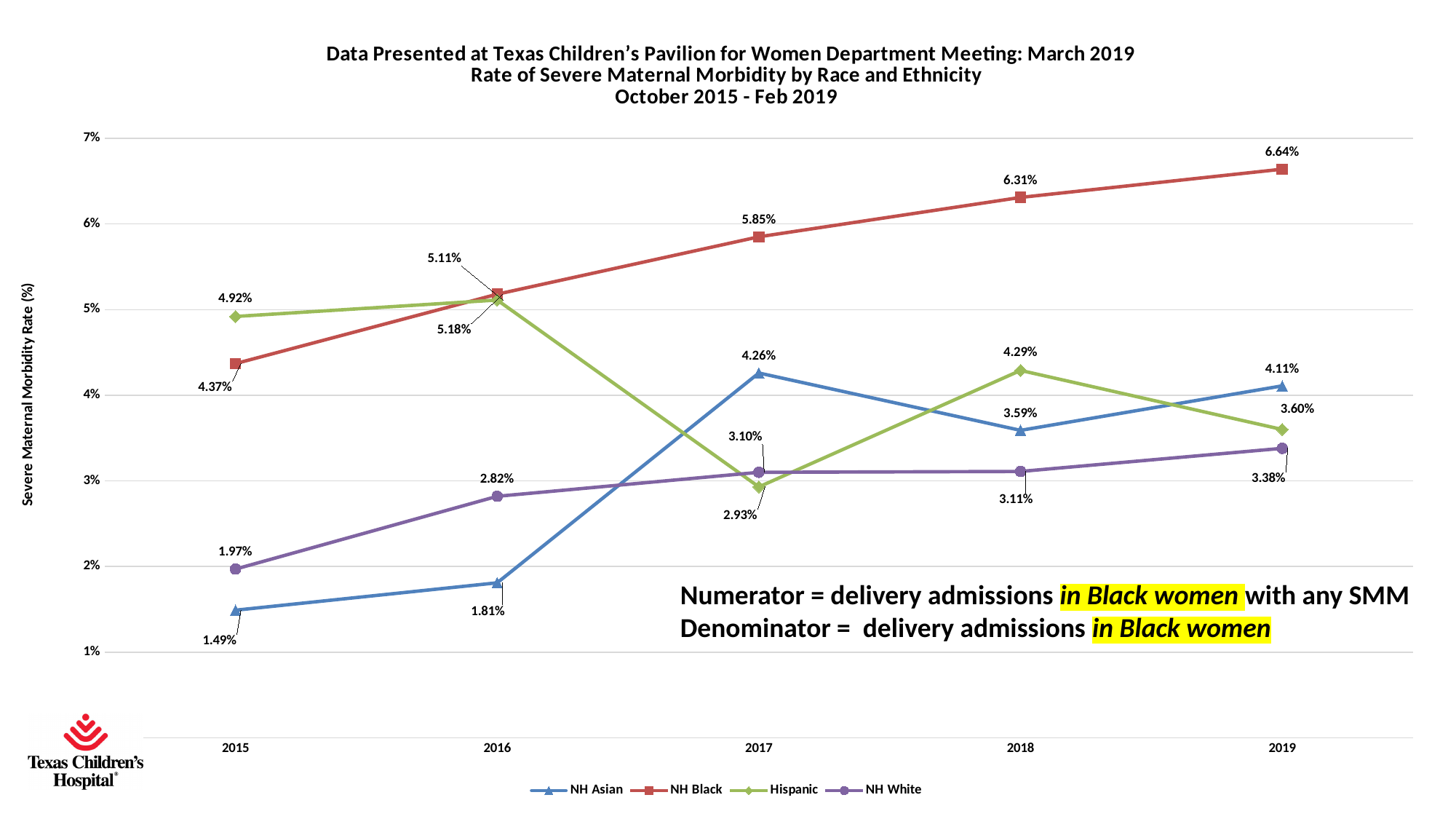
How many years are shown on the x axis? 5 What is the severe maternal morbidity rate for NH White in 2016? 2.82% By how many percentage points did the NH Black rate increase from 2015 to 2019? 2.27 percentage points Which group has the lowest severe maternal morbidity rate in 2015? NH Asian What is the severe maternal morbidity rate for Hispanic in 2015? 4.92% What kind of chart is shown on the slide? Line chart What is the severe maternal morbidity rate for NH Asian in 2017? 4.26% How many series does the legend list? 4 What is the severe maternal morbidity rate for NH Black in 2019? 6.64% Which group has the highest severe maternal morbidity rate in 2019? NH Black Does the NH Black rate rise or fall from 2015 to 2019? Rises In 2018, which group has the higher rate: Hispanic or NH Asian? Hispanic